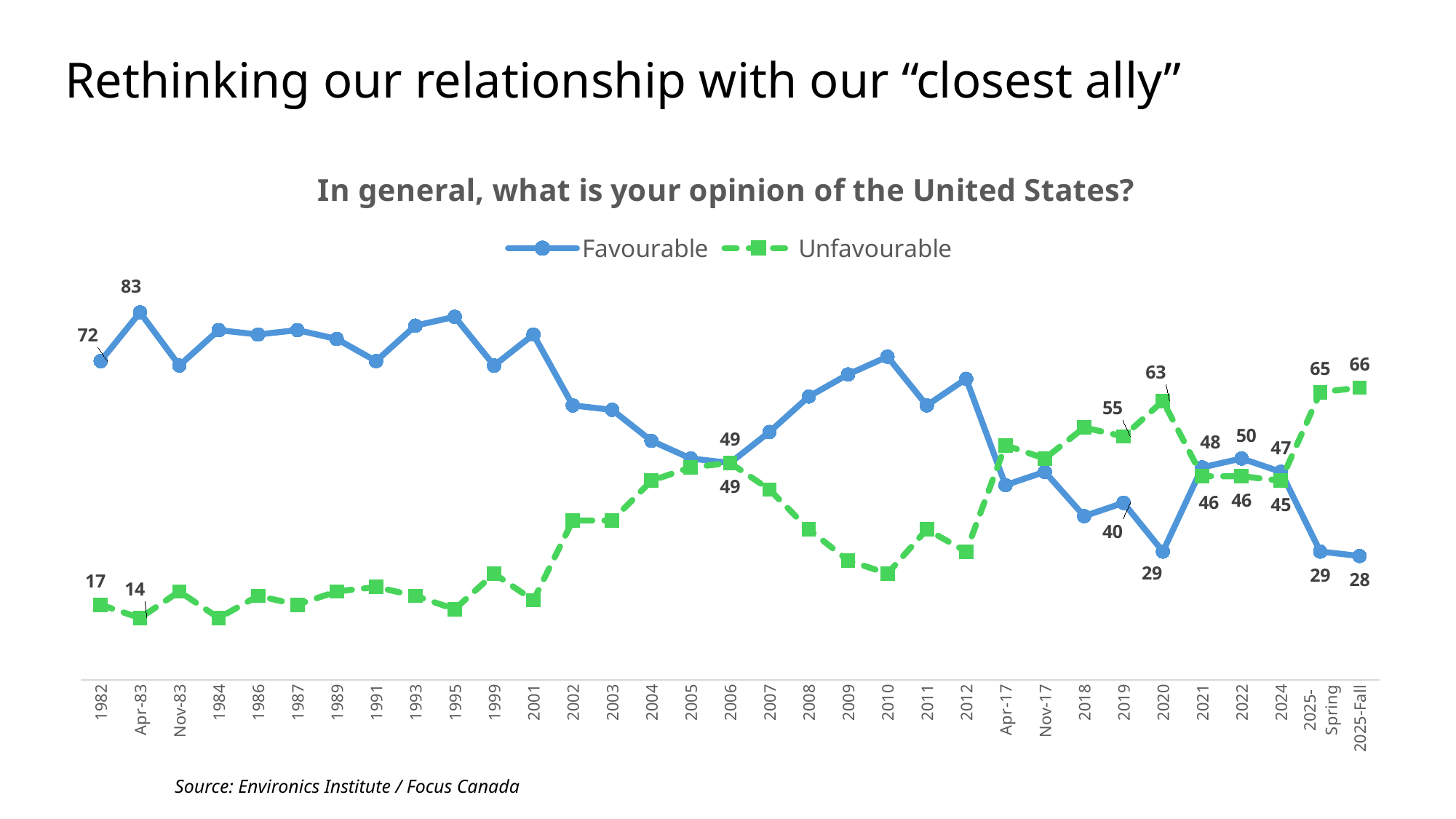
In 2025-Fall, what is the difference between the Unfavourable and Favourable values? 38 In which period does the Favourable series reach its lowest value? 2025-Fall What is the Favourable value in Apr-83? 83 By how much did the Favourable value rise from 1982 to Apr-83? 11 What is the Favourable value in 2020? 29 What is the Unfavourable value in 2020? 63 In which period does the Favourable series reach its highest value? Apr-83 What is the Unfavourable value in 2025-Fall? 66 How many series does the legend list? 2 In 2022, which is larger, the Favourable or the Unfavourable value? Favourable Does the Unfavourable series rise or fall from 2021 to 2025-Fall? Rise What kind of chart is shown on the slide? Line chart